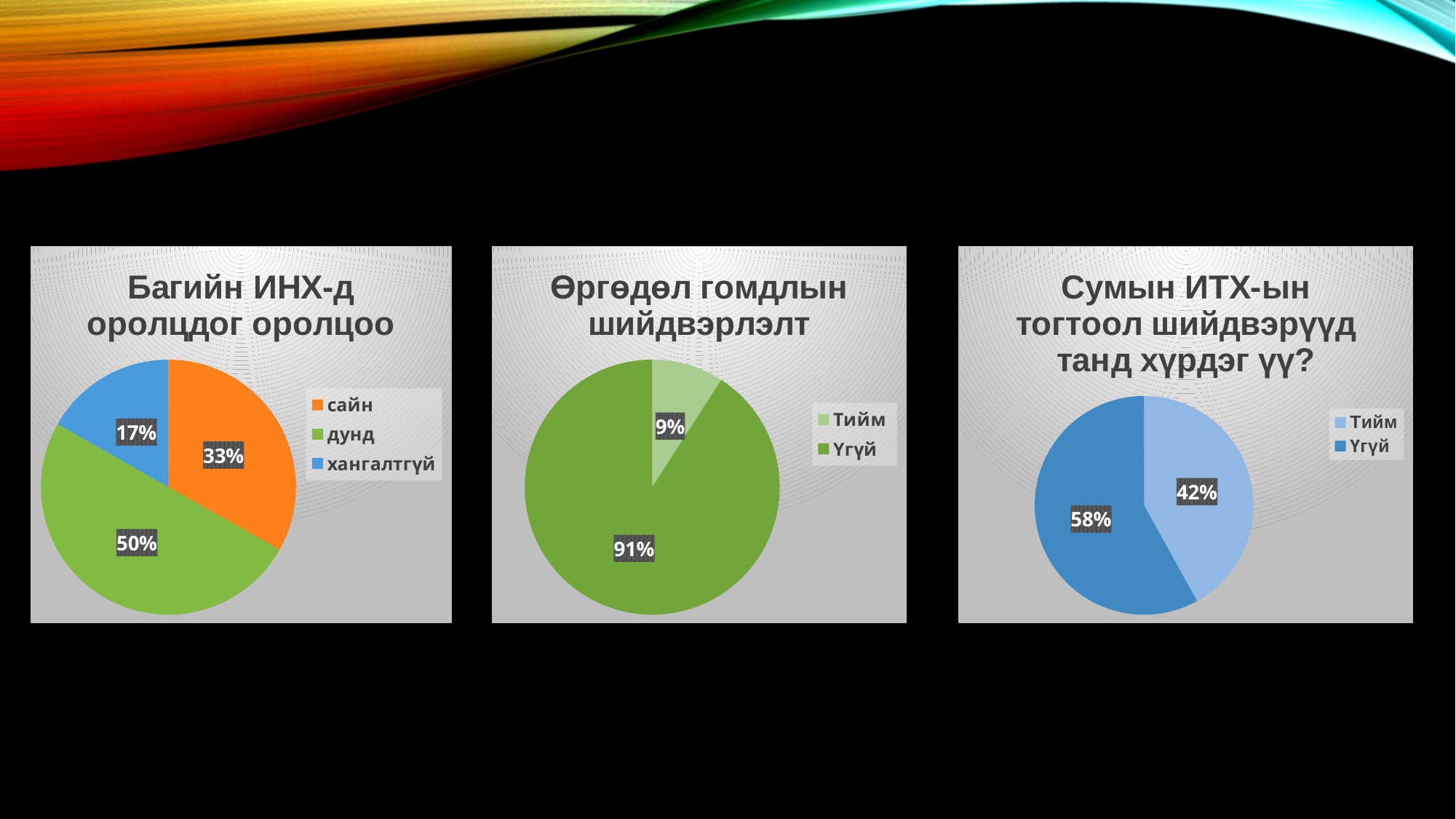
How many categories does the left chart titled "Багийн ИНХ-д оролцдог оролцоо" show? 3 In the left chart titled "Багийн ИНХ-д оролцдог оролцоо", which category has the largest share? дунд In the middle chart titled "Өргөдөл гомдлын шийдвэрлэлт", which is larger, "Тийм" or "Үгүй"? Үгүй In the left chart titled "Багийн ИНХ-д оролцдог оролцоо", what is the value for "дунд"? 50% In the left chart titled "Багийн ИНХ-д оролцдог оролцоо", which category has the smallest share? хангалтгүй In the right chart titled "Сумын ИТХ-ын тогтоол шийдвэрүүд танд хүрдэг үү?", what is the difference between "Үгүй" and "Тийм"? 16% What kind of chart is the right chart titled "Сумын ИТХ-ын тогтоол шийдвэрүүд танд хүрдэг үү?"? Pie chart In the right chart titled "Сумын ИТХ-ын тогтоол шийдвэрүүд танд хүрдэг үү?", what is the value for "Үгүй"? 58% In the left chart titled "Багийн ИНХ-д оролцдог оролцоо", what is the value for "хангалтгүй"? 17% In the middle chart titled "Өргөдөл гомдлын шийдвэрлэлт", what is the value for "Тийм"? 9% In the left chart titled "Багийн ИНХ-д оролцдог оролцоо", what is the difference between the "сайн" and "хангалтгүй" shares? 16% In the middle chart titled "Өргөдөл гомдлын шийдвэрлэлт", what is the value for "Үгүй"? 91%